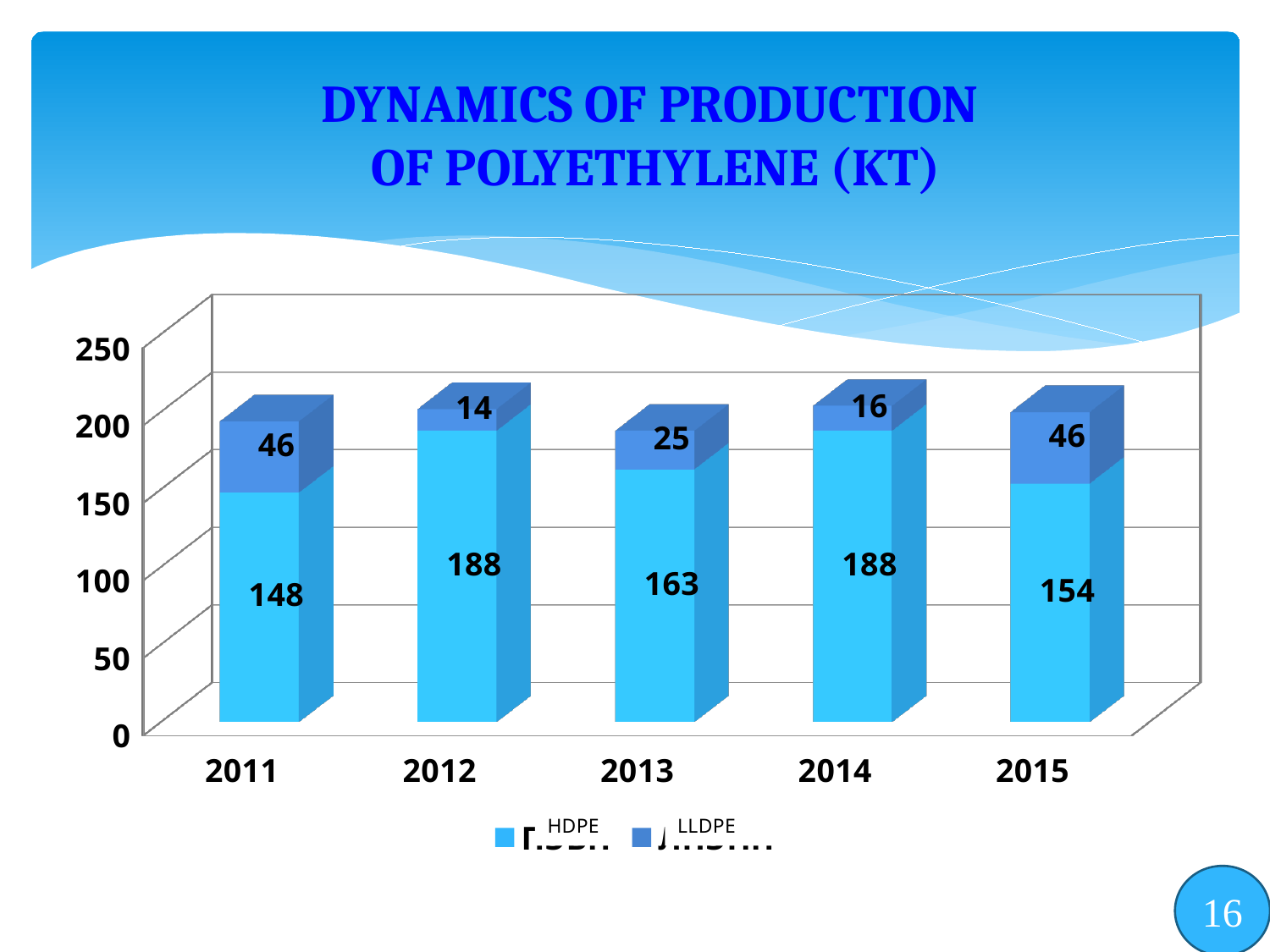
What is the difference between HDPE production in 2012 and in 2011? 40 Which year has the lowest HDPE production? 2011 What is the total polyethylene production (HDPE plus LLDPE) in 2011? 194 What is the total polyethylene production (HDPE plus LLDPE) in 2014? 204 How many years are shown on the x axis of the chart? 5 How many series does the legend list? 2 What is the LLDPE production value for 2012? 14 Which year has the lowest LLDPE production? 2012 Is LLDPE production larger in 2013 or in 2014? 2013 What type of chart is shown on the slide? Stacked bar chart What is the HDPE production value for 2013? 163 What is the LLDPE production value for 2015? 46